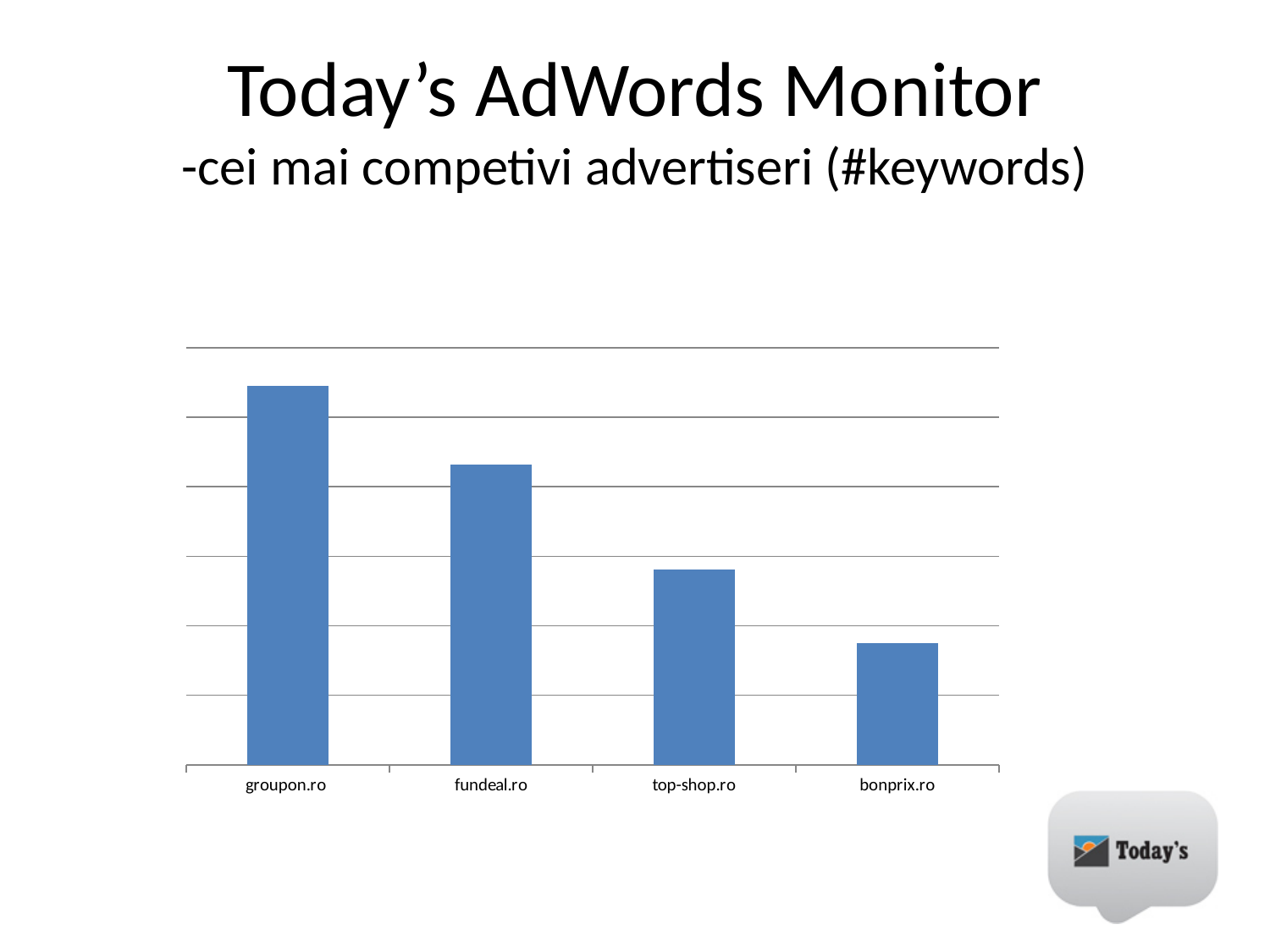
What kind of chart is shown on the slide? bar chart Do the bar values rise or fall from left to right across the chart? fall Which has the larger value, fundeal.ro or top-shop.ro? fundeal.ro What is the label of the third bar from the left? top-shop.ro Which has the smaller value, top-shop.ro or bonprix.ro? bonprix.ro What is the title of the slide containing the chart? Today's AdWords Monitor How many advertisers are shown on the x axis of the chart? 4 Which advertiser has the lowest bar in the chart? bonprix.ro Which has the larger value, bonprix.ro or groupon.ro? groupon.ro Which advertiser has the second-highest bar in the chart? fundeal.ro Which advertiser has the highest bar in the chart? groupon.ro